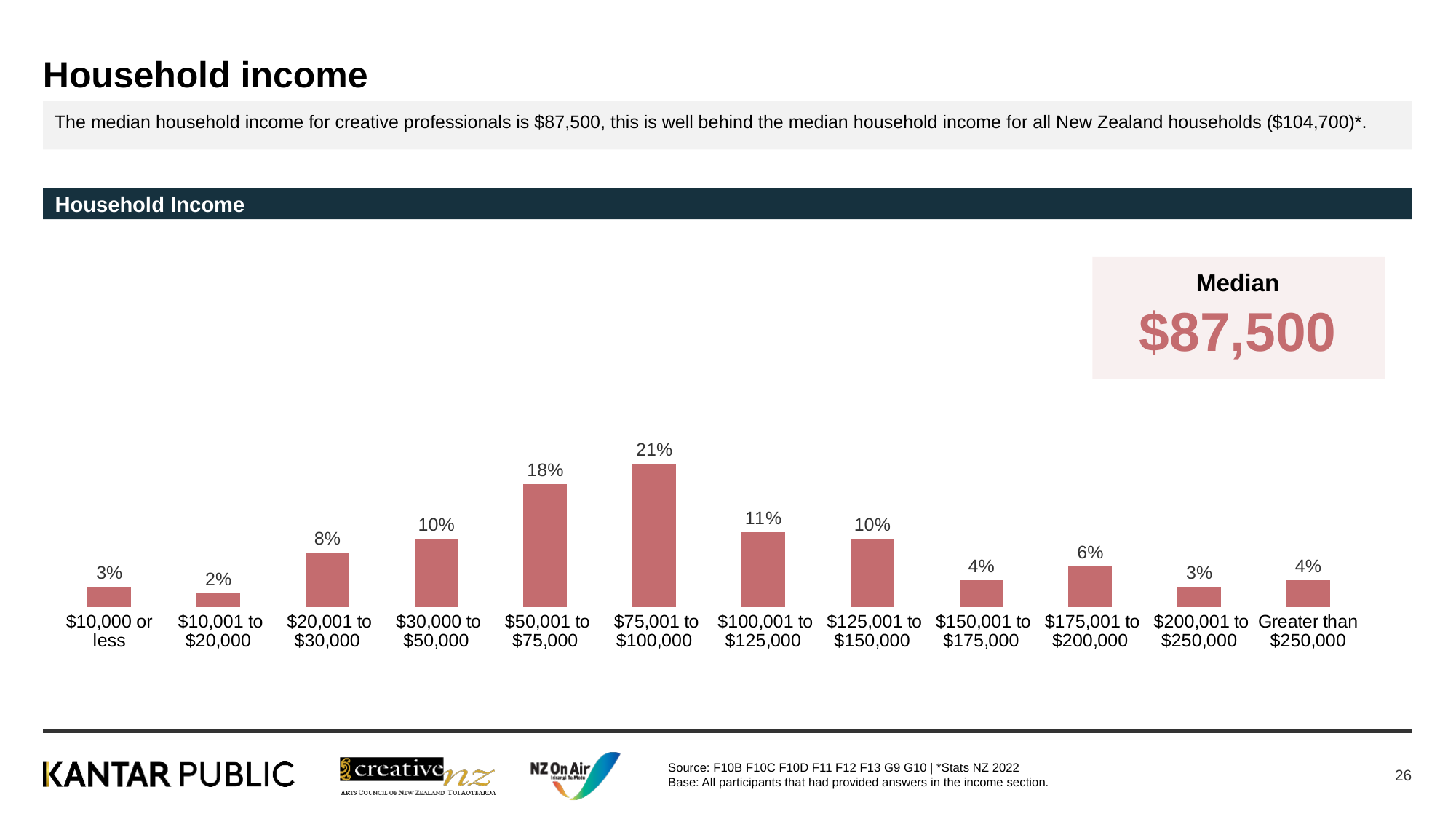
What is the title of the chart? Household Income What type of chart is used to show household income? Bar chart What percentage of creative professionals have a household income of $175,001 to $200,000? 6% Which household income band has the lowest percentage? $10,001 to $20,000 What is the median household income shown on the slide? $87,500 What is the combined percentage for the $20,001 to $30,000 and $30,000 to $50,000 bands? 18% What percentage of creative professionals have a household income of $75,001 to $100,000? 21% What is the difference in percentage points between the $75,001 to $100,000 band and the $50,001 to $75,000 band? 3 What percentage of creative professionals have a household income of $10,000 or less? 3% Which household income band has the highest percentage? $75,001 to $100,000 How many household income bands are shown in the chart? 12 Which is larger: the percentage for $100,001 to $125,000 or for $125,001 to $150,000? $100,001 to $125,000